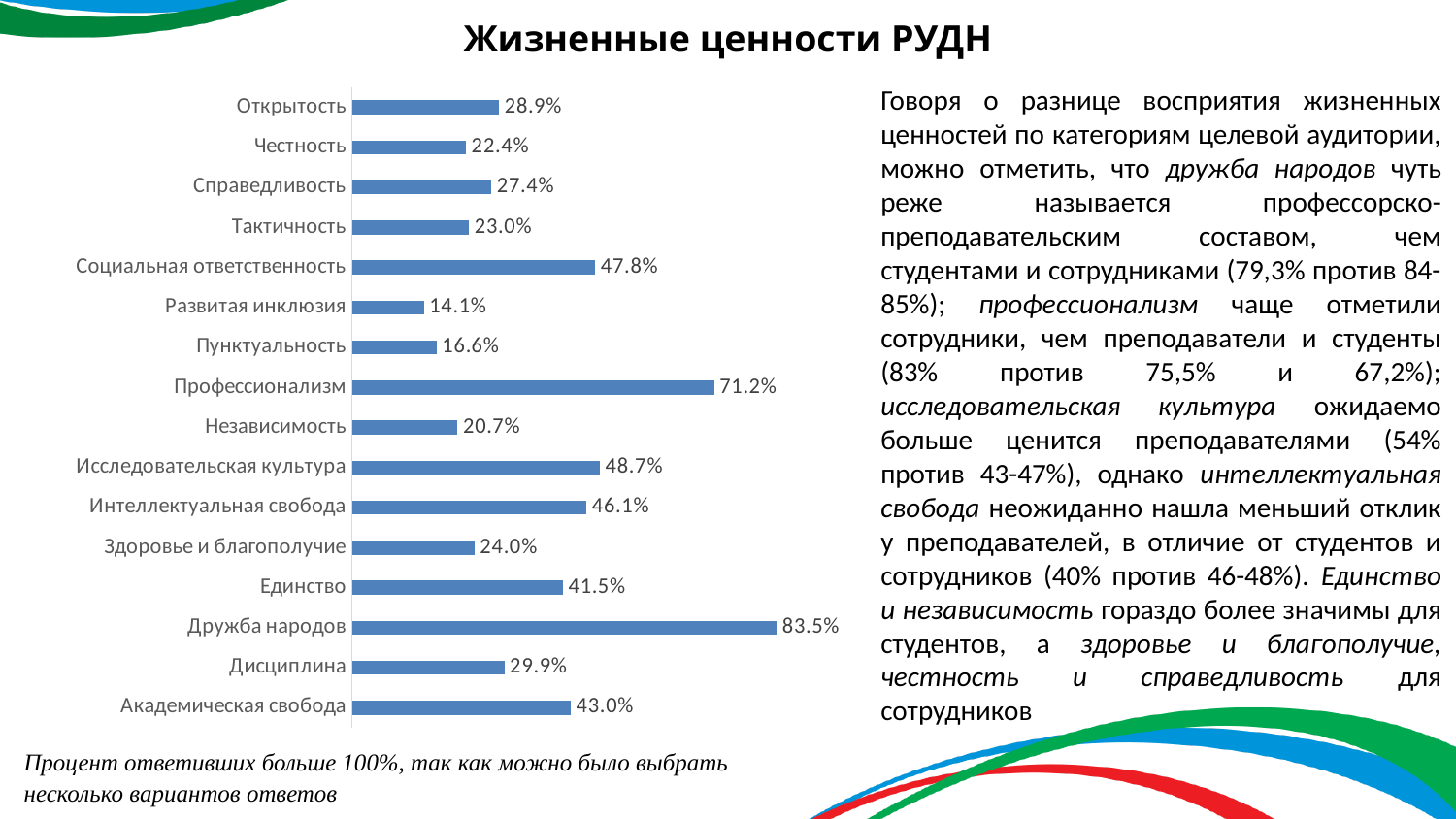
Which category has the highest value? Дружба народов What is the value for Здоровье и благополучие? 24.0% What type of chart is shown on the slide? Bar chart What is the value for Дружба народов? 83.5% What is the value for Профессионализм? 71.2% How many categories are shown in the chart? 16 What is the title of the slide containing the chart? Жизненные ценности РУДН What is the value for Социальная ответственность? 47.8% Which is larger, the value for Академическая свобода or the value for Единство? Академическая свобода Which category has the lowest value? Развитая инклюзия What is the difference between the values for Социальная ответственность and Единство? 6.3% What is the difference between the values for Дружба народов and Профессионализм? 12.3%